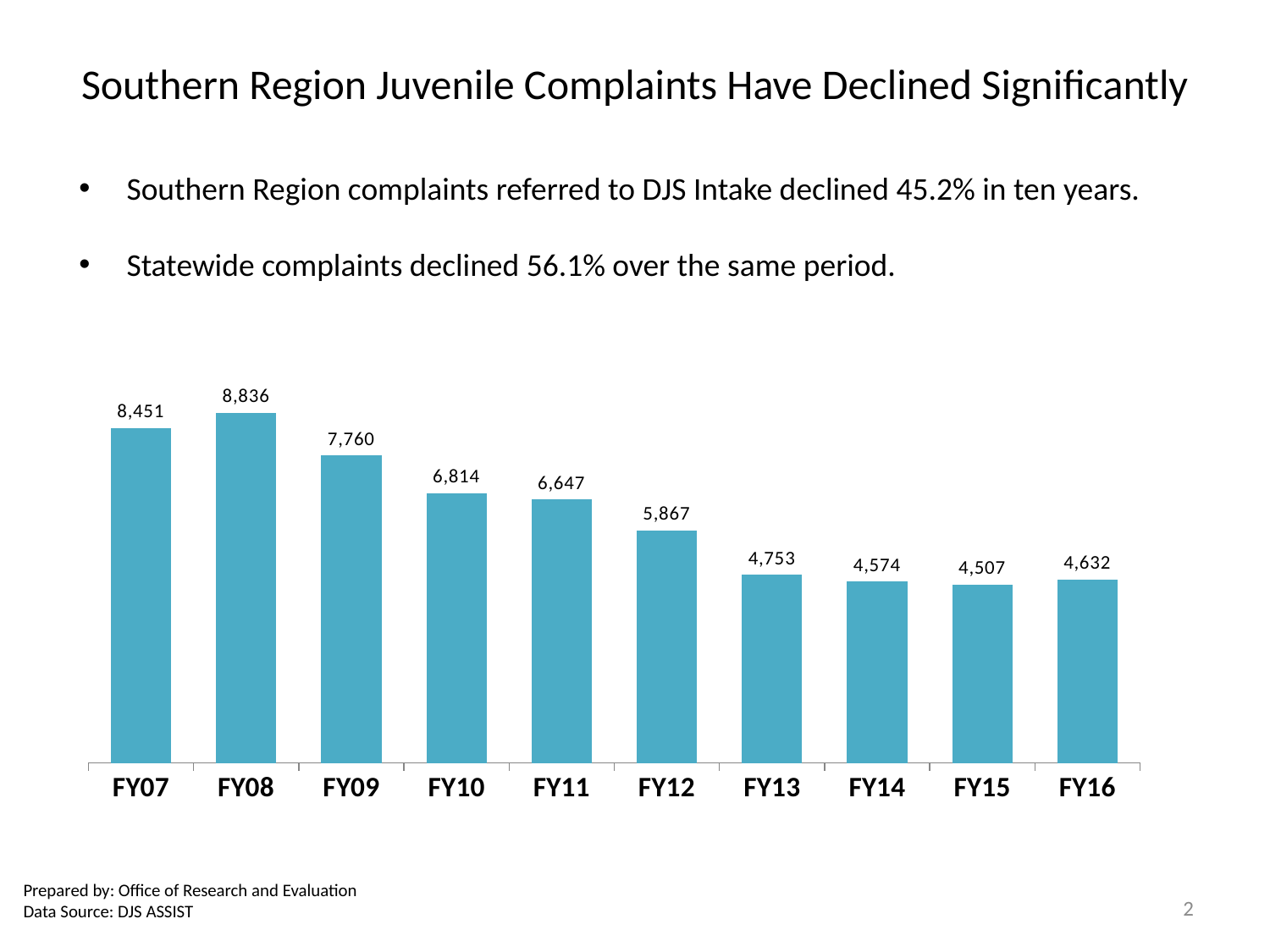
What colour are the bars in the chart? teal blue How many fiscal years are shown on the x axis? 10 Which fiscal year has the highest value? FY08 What is the difference between the values for FY08 and FY16? 4,204 Do the values generally rise or fall from FY08 to FY15? fall What is the value for FY12? 5,867 What is the difference between the values for FY09 and FY10? 946 What is the value for FY07? 8,451 What is the value for FY16? 4,632 Which is larger, the value for FY13 or the value for FY16? FY13 Which fiscal year has the lowest value? FY15 What kind of chart is shown on the slide? bar chart